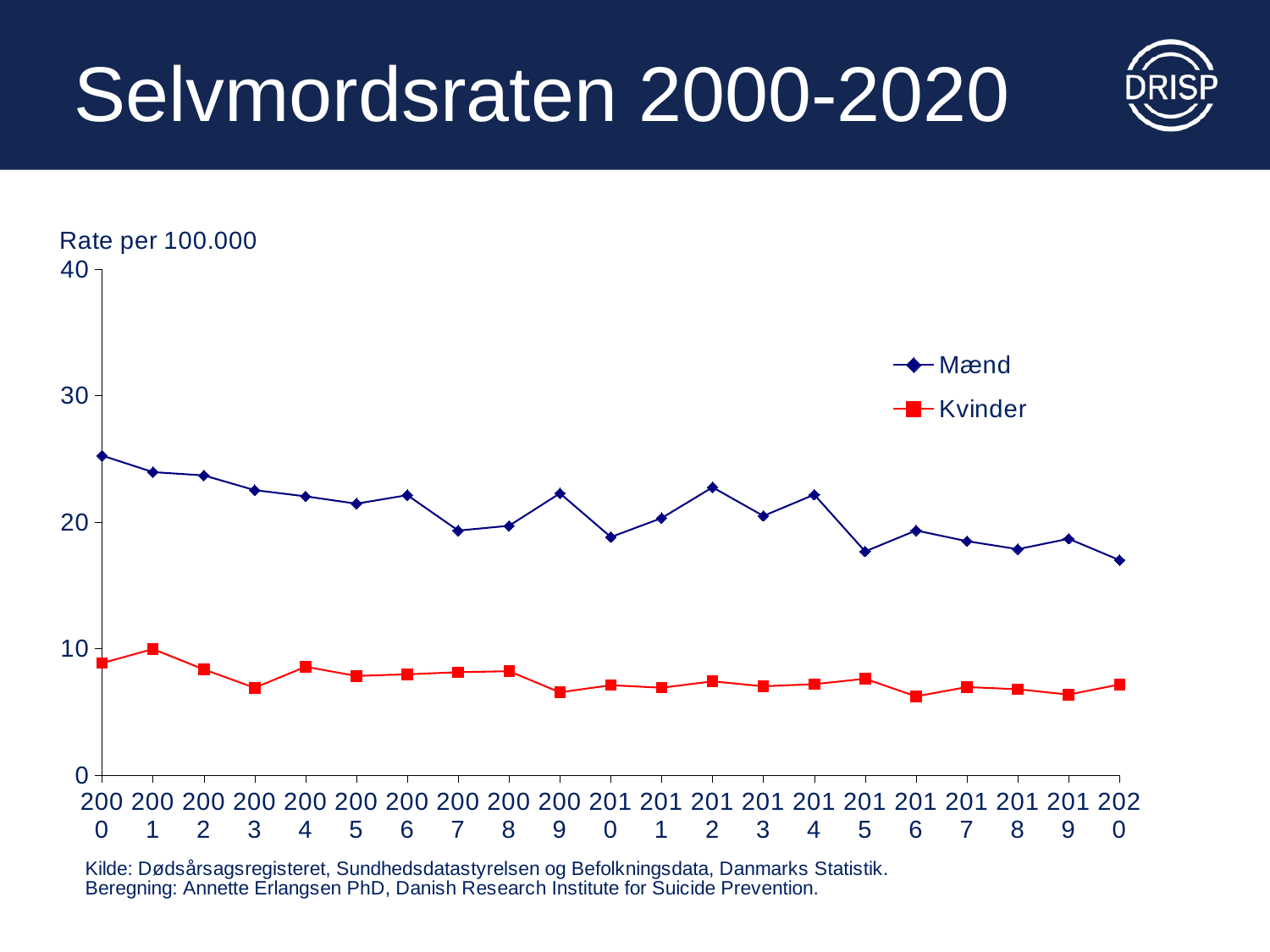
How many series does the legend list? 2 In which year is the Kvinder series highest? 2001 What kind of chart is shown on the slide? Line chart Is the value for Kvinder in 2003 greater or less than 10? less Does the Mænd series overall rise or fall from 2000 to 2020? Fall Is the value for Mænd in 2020 greater or less than 20? less In which year is the Mænd series highest? 2000 How many years are plotted along the x axis? 21 What is the label shown above the y axis? Rate per 100.000 Is the value for Mænd in 2000 greater or less than 20? greater Which series has the larger value in 2010, Mænd or Kvinder? Mænd Which series is shown in red? Kvinder